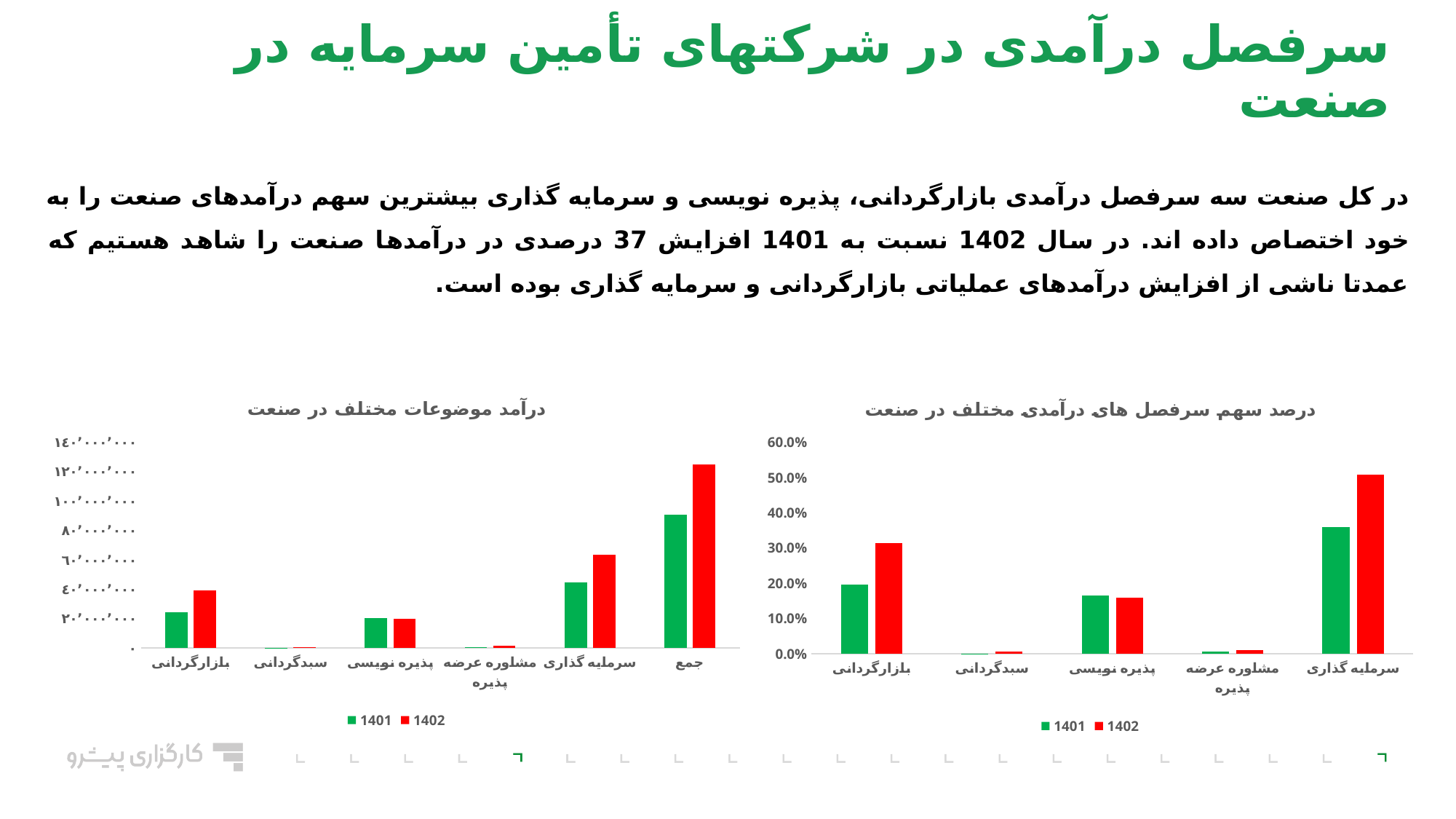
In the right chart «درصد سهم سرفصل های درآمدی مختلف در صنعت», is the 1402 value for سرمایه گذاری greater or less than 40.0%? greater In the left chart «درآمد موضوعات مختلف در صنعت», for جمع, which year has the larger value, 1401 or 1402? 1402 In the right chart «درصد سهم سرفصل های درآمدی مختلف در صنعت», which category has the highest value for 1402? سرمایه گذاری In the left chart «درآمد موضوعات مختلف در صنعت», is the 1402 value for جمع greater or less than ۱۰۰٬۰۰۰٬۰۰۰? greater In the right chart «درصد سهم سرفصل های درآمدی مختلف در صنعت», for بازارگردانی, which year has the larger value, 1401 or 1402? 1402 How many categories are shown on the x axis of the right chart «درصد سهم سرفصل های درآمدی مختلف در صنعت»? 5 In the right chart «درصد سهم سرفصل های درآمدی مختلف در صنعت», what colour are the bars for the 1402 series? red In the left chart «درآمد موضوعات مختلف در صنعت», is the 1401 value for سرمایه گذاری greater or less than ۶۰٬۰۰۰٬۰۰۰? less What kind of chart is the left chart titled «درآمد موضوعات مختلف در صنعت»? bar chart In the right chart «درصد سهم سرفصل های درآمدی مختلف در صنعت», how many series does the legend list? 2 How many categories are shown on the x axis of the left chart «درآمد موضوعات مختلف در صنعت»? 6